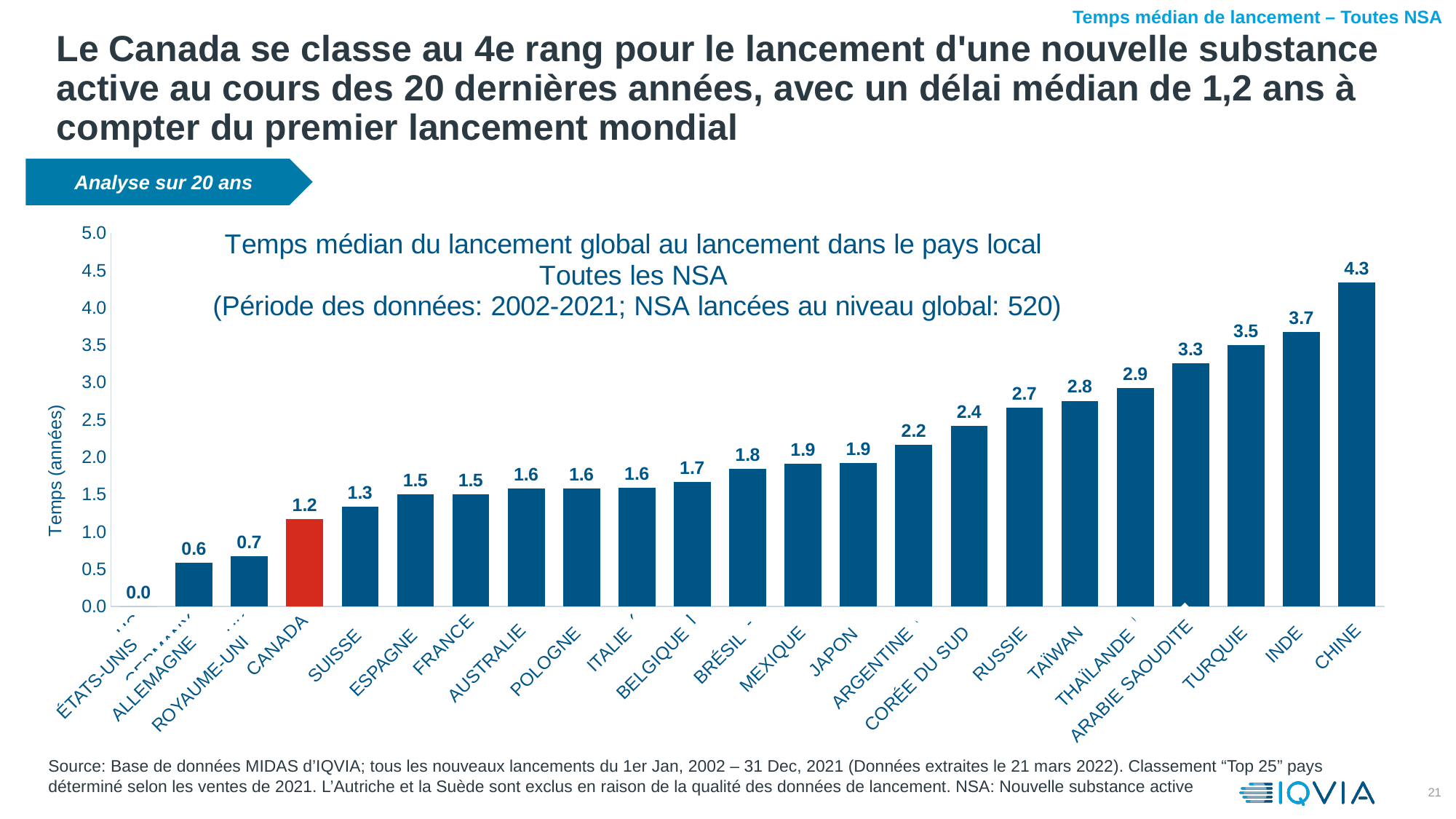
What is the difference between the values for Inde and Canada? 2.5 Which country's bar is highlighted in red? Canada Which country has the highest median launch time? Chine What kind of chart is shown on the slide? Bar chart Is the value for Arabie Saoudite greater or less than 3.0? greater What value is shown for Chine (China)? 4.3 How many countries are shown in the chart? 23 What value is shown for Japon (Japan)? 1.9 Which country has the lowest median launch time? États-Unis What is the median launch time shown for Canada? 1.2 Do the values rise or fall from left to right along the x axis? Rise Which has a larger value, Turquie or Russie? Turquie